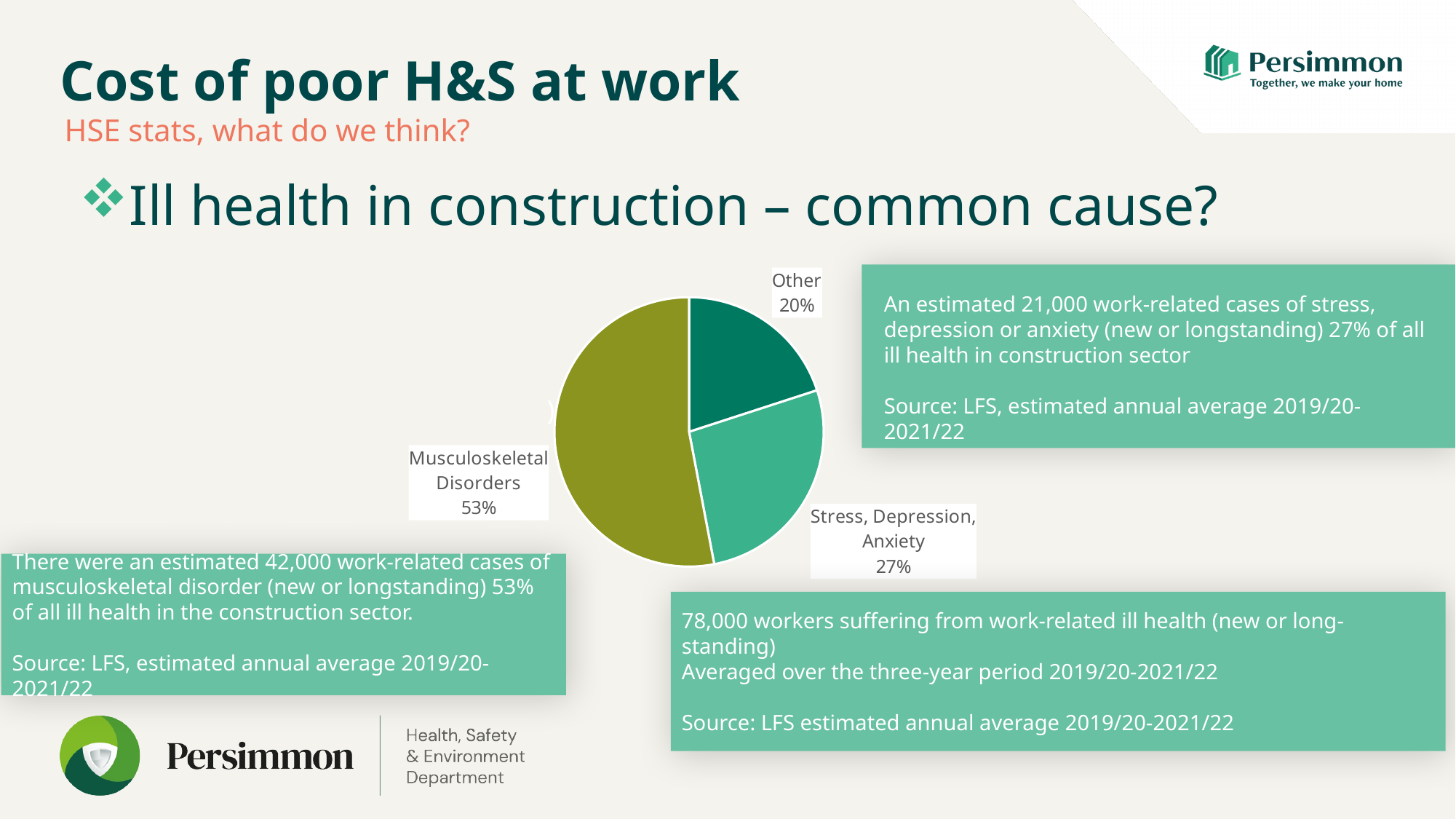
What share of the pie is Musculoskeletal Disorders? 53% What share of the pie is Other? 20% What is the difference in percentage points between Musculoskeletal Disorders and Stress, Depression, Anxiety? 26 What share of the pie is Stress, Depression, Anxiety? 27% How many slices does the pie chart have? 3 Is the share for Musculoskeletal Disorders greater or less than 50%? greater What colour is the Musculoskeletal Disorders slice? olive green Which is larger: the Stress, Depression, Anxiety slice or the Other slice? Stress, Depression, Anxiety What is the combined share of Stress, Depression, Anxiety and Other? 47% What kind of chart is shown on the slide? pie chart Which slice of the pie chart is the largest? Musculoskeletal Disorders Which slice of the pie chart is the smallest? Other